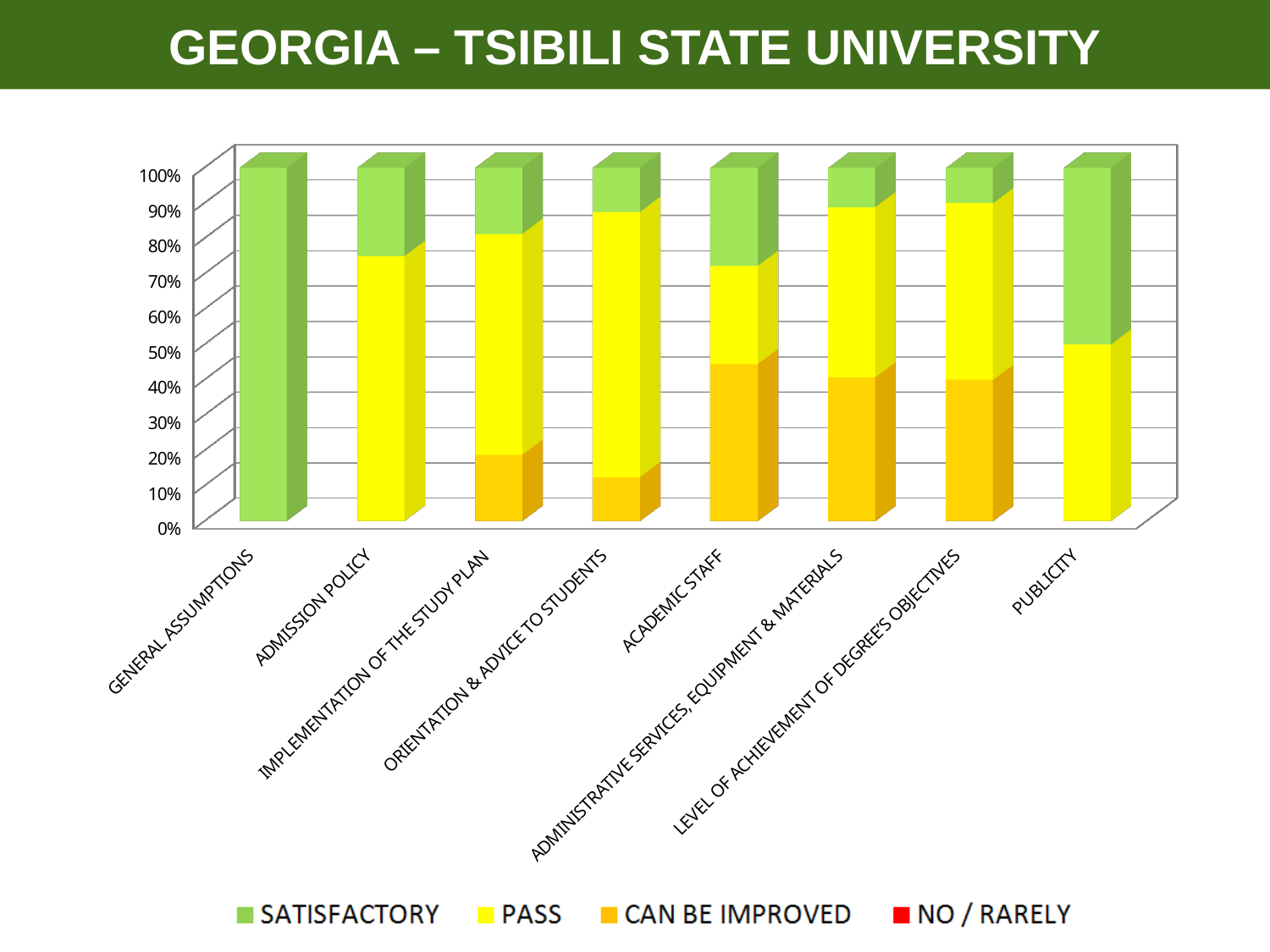
Is the PASS value for PUBLICITY greater or less than 70%? less What are the four series listed in the chart's legend? SATISFACTORY, PASS, CAN BE IMPROVED, NO / RARELY Which colour represents the NO / RARELY series in the legend? red Is the CAN BE IMPROVED value for ACADEMIC STAFF greater or less than 30%? greater Is the SATISFACTORY value for GENERAL ASSUMPTIONS greater or less than 90%? greater How many categories are shown along the x axis of the chart? 8 Which has the larger CAN BE IMPROVED share, ACADEMIC STAFF or IMPLEMENTATION OF THE STUDY PLAN? ACADEMIC STAFF How many series does the chart's legend list? 4 What kind of chart is shown on the slide? stacked bar chart Which category has the largest SATISFACTORY share? GENERAL ASSUMPTIONS